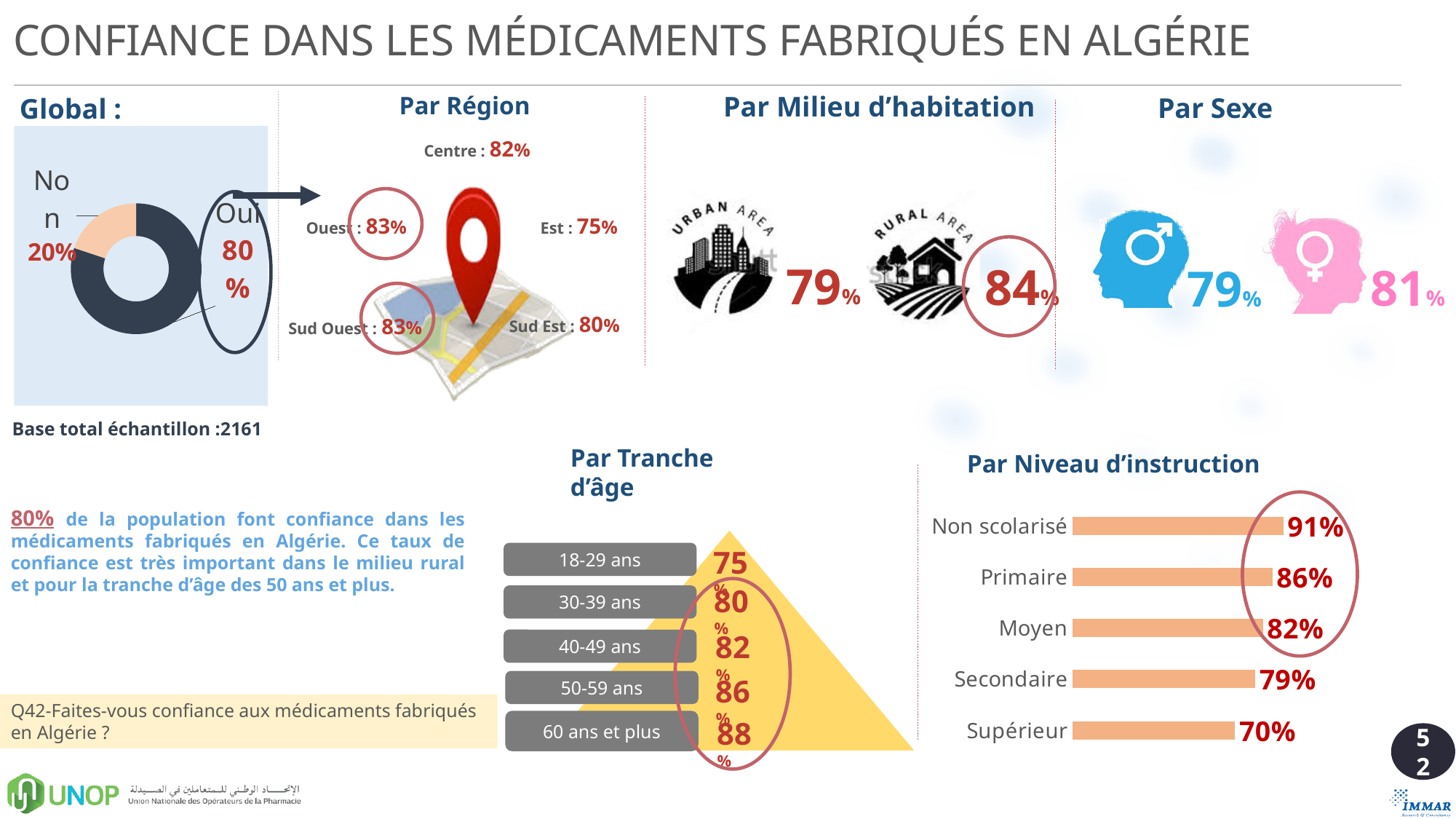
In the 'Par Niveau d'instruction' chart, what is the difference between 'Primaire' and 'Secondaire'? 7% In the 'Par Niveau d'instruction' chart, which category has the lowest value? Supérieur What kind of chart is the 'Par Niveau d'instruction' chart? Bar chart In the 'Par Milieu d'habitation' section, which is larger, the urban value or the rural value? Rural (84%) In the 'Par Tranche d'âge' chart, what is the value for '60 ans et plus'? 88% In the 'Par Tranche d'âge' chart, do the values rise or fall from the youngest to the oldest age group? Rise In the 'Global' chart, what share of respondents answered 'Non'? 20% In the 'Par Niveau d'instruction' chart, which category has the highest value? Non scolarisé In the 'Global' chart, what share of respondents answered 'Oui'? 80% In the 'Par Niveau d'instruction' chart, what is the value for 'Non scolarisé'? 91% What kind of chart is the 'Global' chart? Donut (pie) chart How many categories are shown in the 'Par Niveau d'instruction' chart? 5